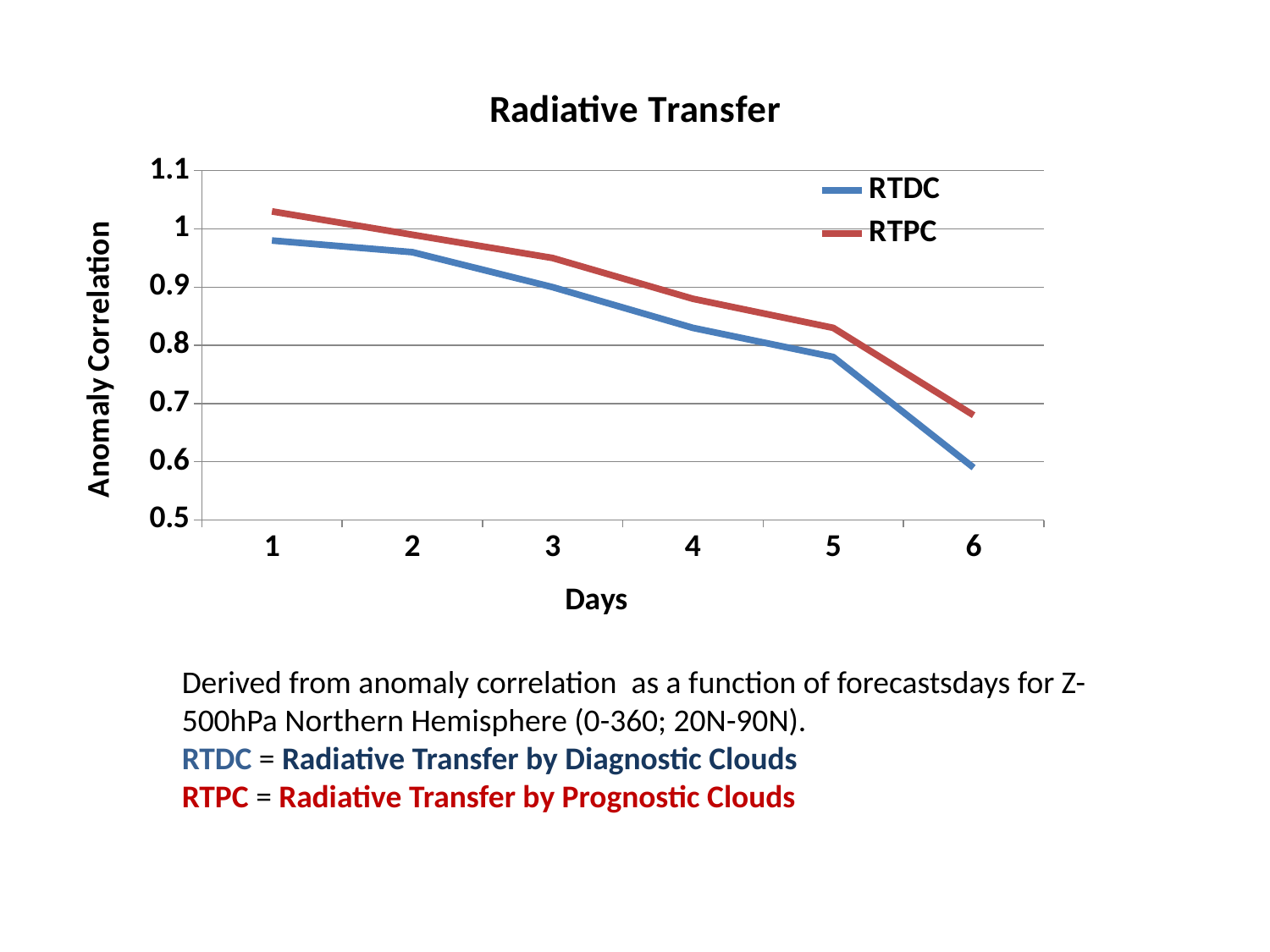
How many series does the legend list? 2 At which day is the RTDC anomaly correlation highest? 1 What is the title of the chart? Radiative Transfer Is the RTPC value at day 1 greater or less than 0.9? greater Is the RTDC value at day 3 greater or less than 0.8? greater At which day is the RTPC anomaly correlation lowest? 6 At day 6, which series has the larger anomaly correlation, RTDC or RTPC? RTPC How many days are plotted along the x axis? 6 Do the RTDC values rise or fall as the number of days increases? fall What kind of chart is shown on the slide? line chart Is the RTDC value at day 6 greater or less than 0.7? less